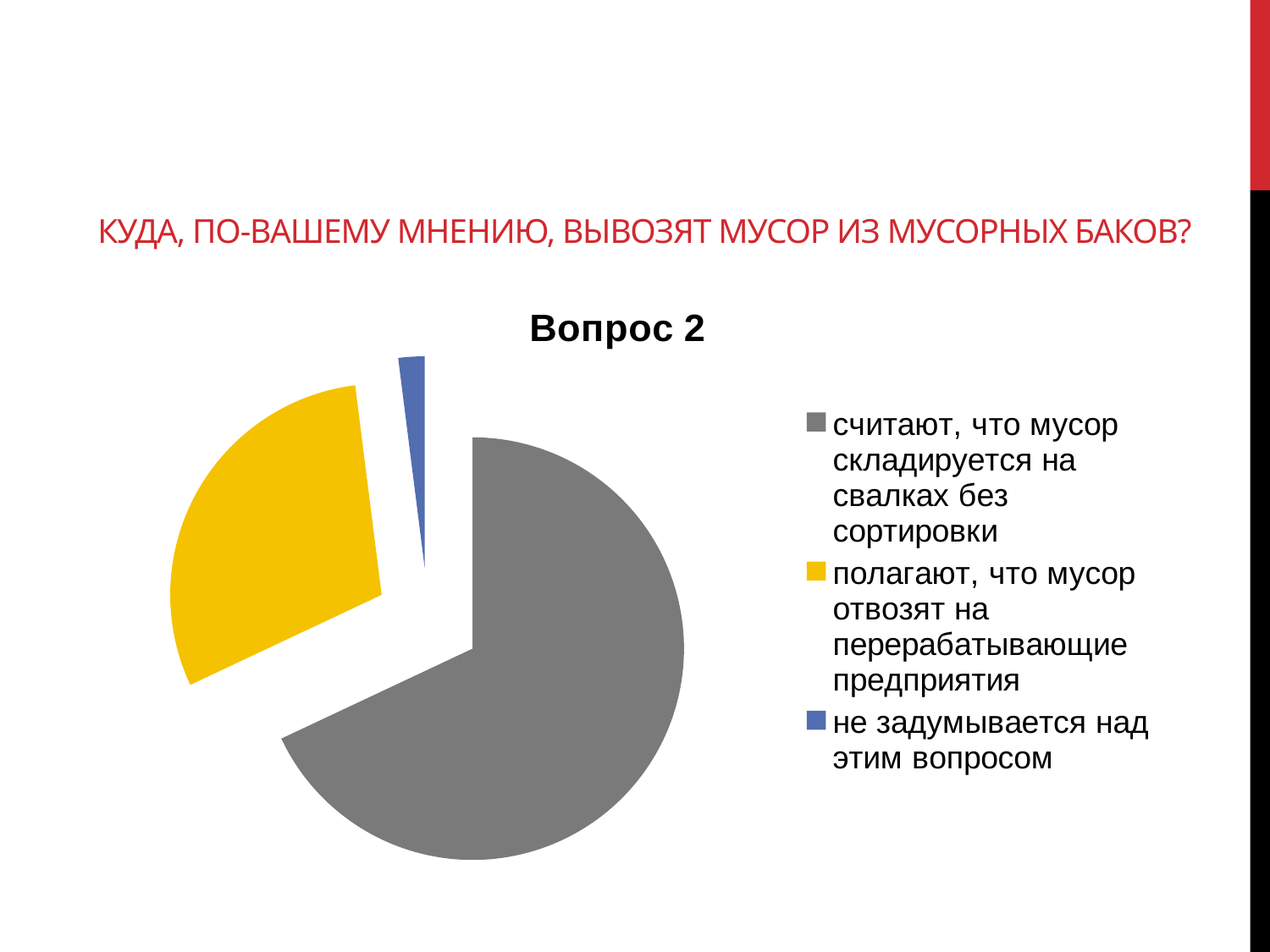
What is the title of the chart? Вопрос 2 Which slice is larger: 'полагают, что мусор отвозят на перерабатывающие предприятия' or 'не задумывается над этим вопросом'? полагают, что мусор отвозят на перерабатывающие предприятия Which category has the smallest slice of the pie? не задумывается над этим вопросом Which category has the largest slice of the pie? считают, что мусор складируется на свалках без сортировки What colour is the slice for 'не задумывается над этим вопросом'? blue How many entries does the legend list? 3 What kind of chart is shown on the slide? pie chart How many slices does the pie chart have? 3 Which slice is larger: 'считают, что мусор складируется на свалках без сортировки' or 'полагают, что мусор отвозят на перерабатывающие предприятия'? считают, что мусор складируется на свалках без сортировки